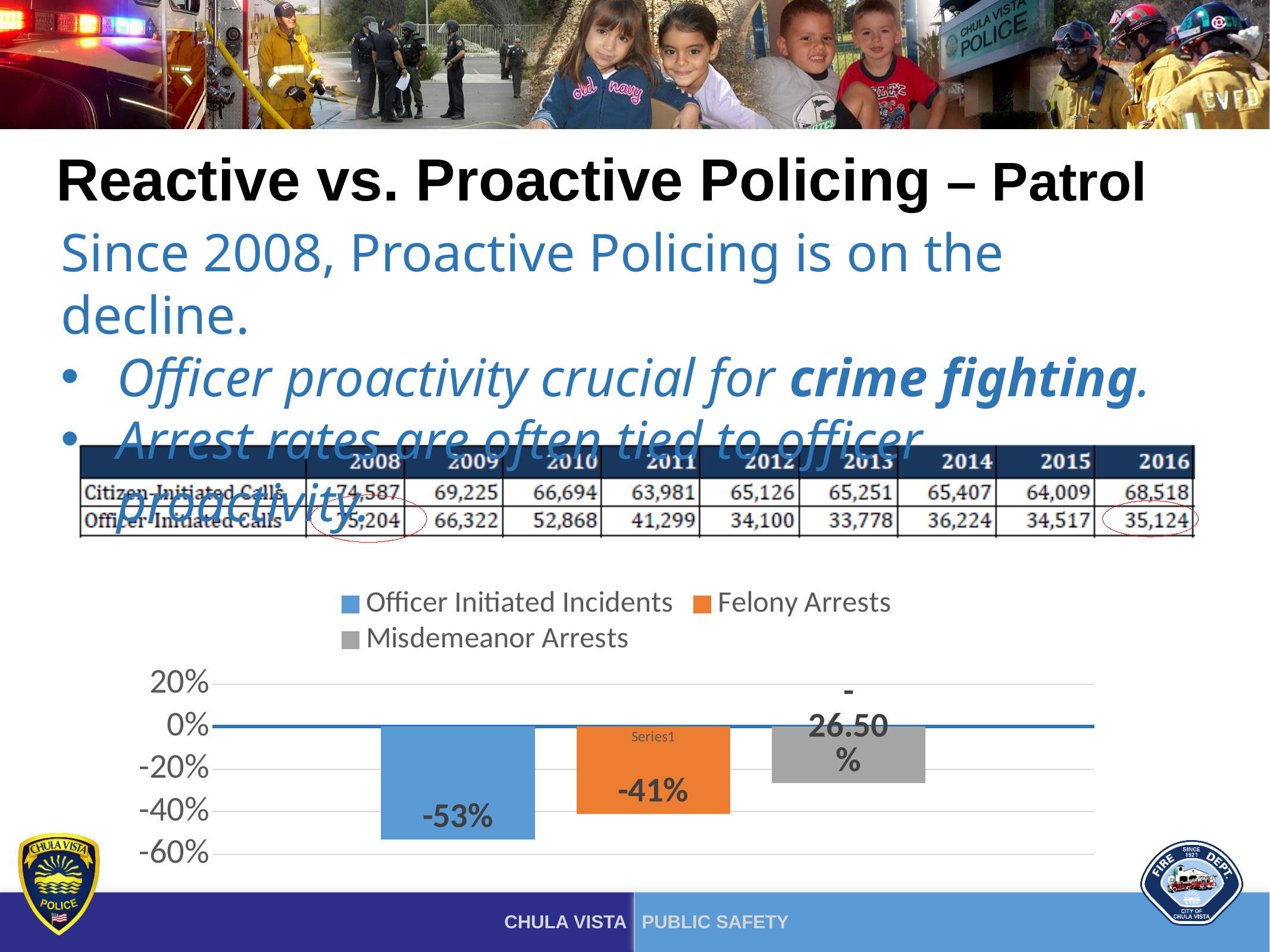
How many series does the legend of the bar chart list? 3 What is the value shown for Officer Initiated Incidents in the bar chart? -53% What is the difference between the Officer Initiated Incidents value and the Felony Arrests value in the bar chart? 12% Is the value for Felony Arrests in the bar chart greater or less than -20%? less How many bars are plotted in the bar chart? 3 What is the value shown for Felony Arrests in the bar chart? -41% In the bar chart, which is larger: the value for Felony Arrests or the value for Officer Initiated Incidents? Felony Arrests What kind of chart is shown at the bottom of the slide? bar chart What is the value shown for Misdemeanor Arrests in the bar chart? -26.50% Which series in the bar chart has the lowest (most negative) value? Officer Initiated Incidents Which series in the bar chart has the highest (least negative) value? Misdemeanor Arrests What colour is the Felony Arrests bar in the chart? orange